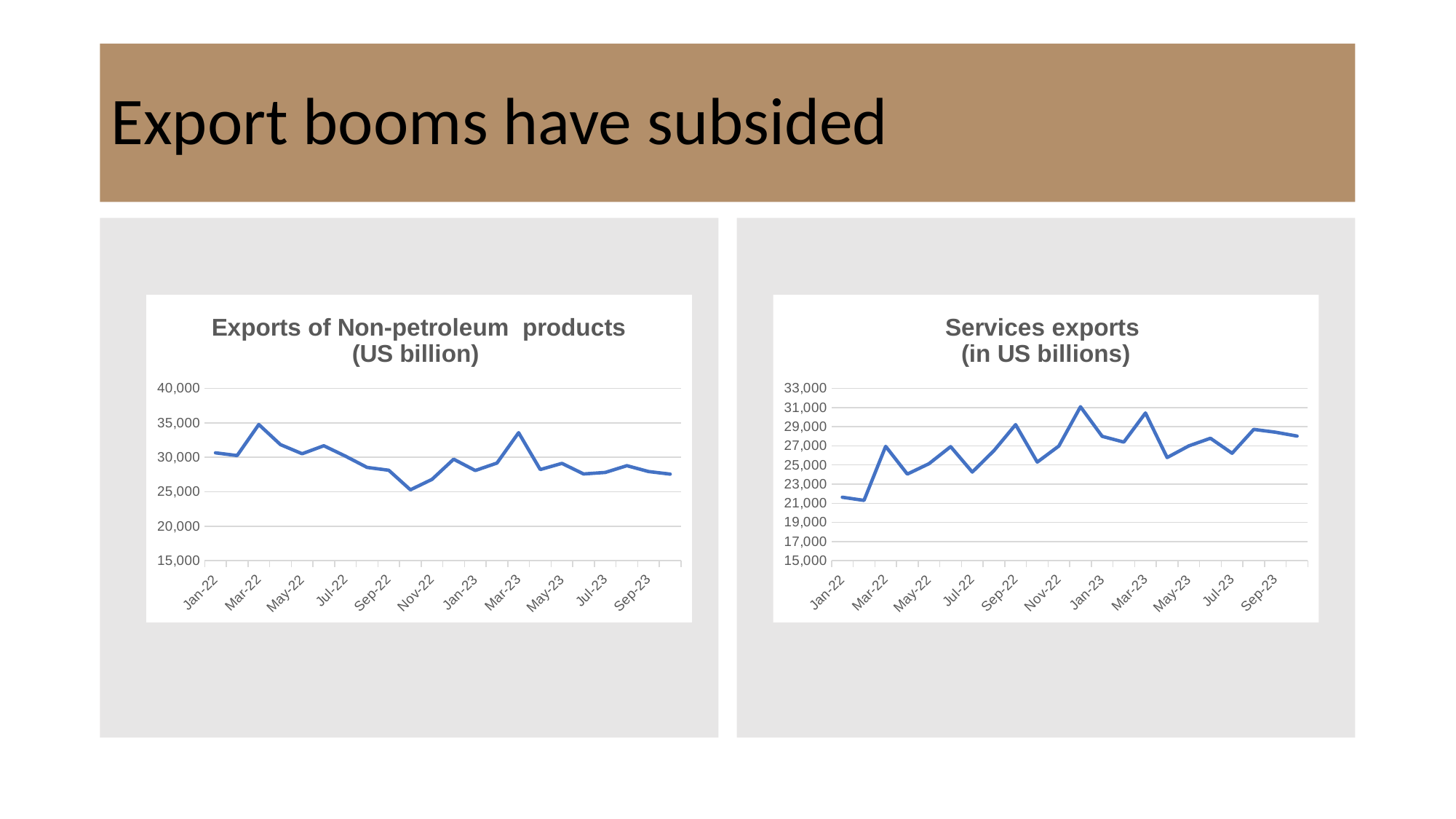
What kind of chart is the 'Exports of Non-petroleum products (US billion)' chart? line chart What kind of chart is the 'Services exports (in US billions)' chart? line chart In the 'Services exports' chart, which labeled month has the highest value? Mar-23 In the 'Exports of Non-petroleum products' chart, which labeled month has the highest value? Mar-22 In the 'Exports of Non-petroleum products' chart, is the value for Mar-22 greater or less than 30,000? greater How many month labels are shown on the x axis of the 'Services exports' chart? 11 In the 'Services exports' chart, is the value for Jan-23 greater or less than 29,000? less In the 'Exports of Non-petroleum products' chart, which is larger, the value for Mar-22 or the value for Sep-23? Mar-22 In the 'Exports of Non-petroleum products' chart, is the value for Sep-23 greater or less than 30,000? less In the 'Services exports' chart, which is larger, the value for Jan-22 or the value for Sep-23? Sep-23